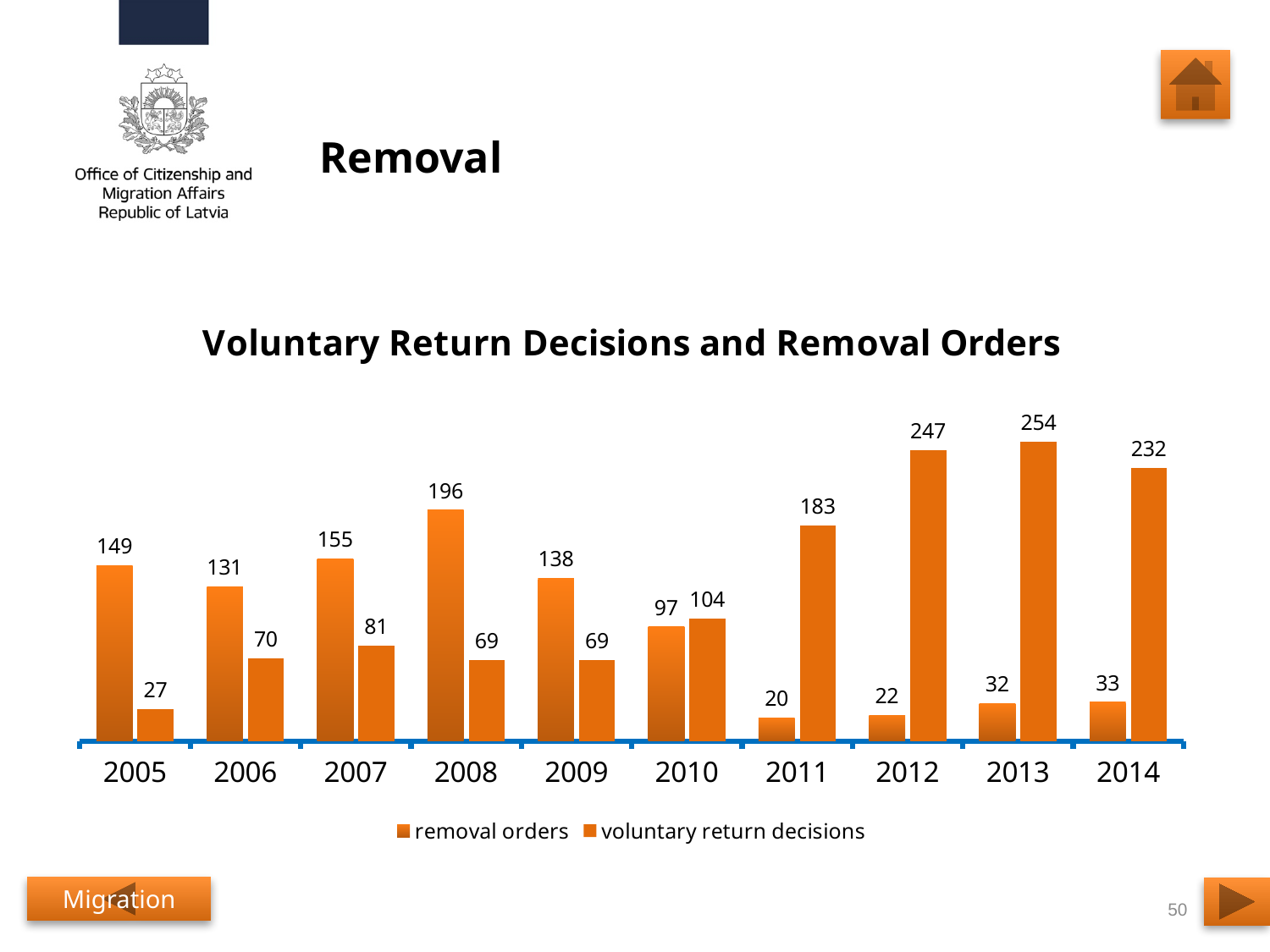
What is the title of the chart? Voluntary Return Decisions and Removal Orders What is the value for removal orders in 2008? 196 What is the difference between removal orders and voluntary return decisions in 2005? 122 What is the value for voluntary return decisions in 2012? 247 In which year are voluntary return decisions highest? 2013 What kind of chart is shown? bar chart How many years are shown on the x axis? 10 In which year are removal orders lowest? 2011 How many series does the legend list? 2 Which is larger in 2010: removal orders or voluntary return decisions? voluntary return decisions What is the value for removal orders in 2011? 20 Do voluntary return decisions rise or fall from 2009 to 2013? rise